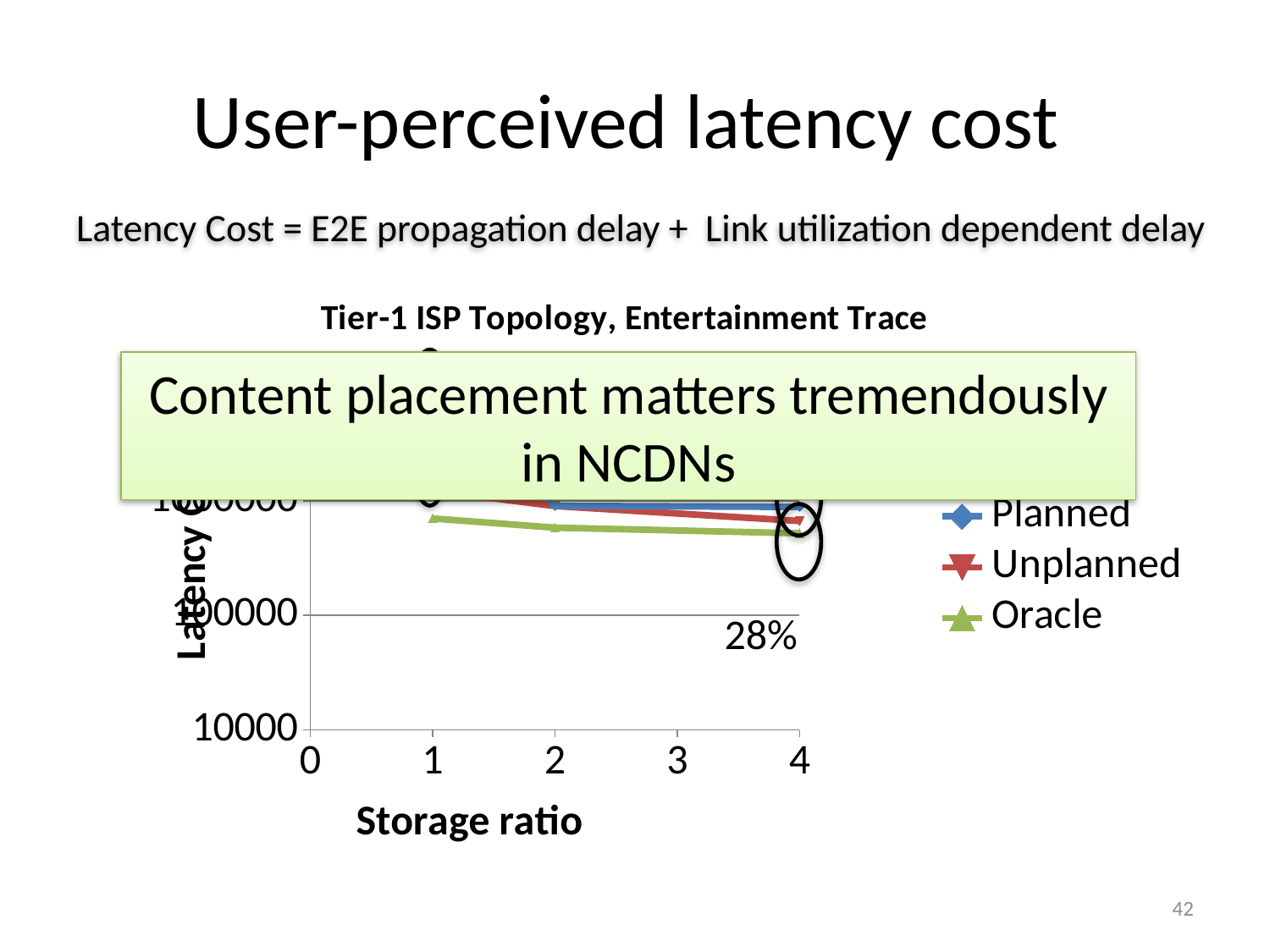
What are the series names listed in the chart legend? Planned, Unplanned, Oracle Is the latency cost for Oracle at a storage ratio of 4 greater or less than 1000000? less What kind of chart is shown on the slide? line chart Which series has the lowest latency cost at a storage ratio of 4? Oracle Is the latency cost for Unplanned at a storage ratio of 4 greater or less than 100000? greater Is the latency cost for Oracle at a storage ratio of 4 greater or less than 100000? greater What is the title of the chart? Tier-1 ISP Topology, Entertainment Trace What percentage is annotated near the right end of the chart? 28% Does the latency cost for Oracle rise or fall as the storage ratio increases? fall How many series does the chart legend list? 3